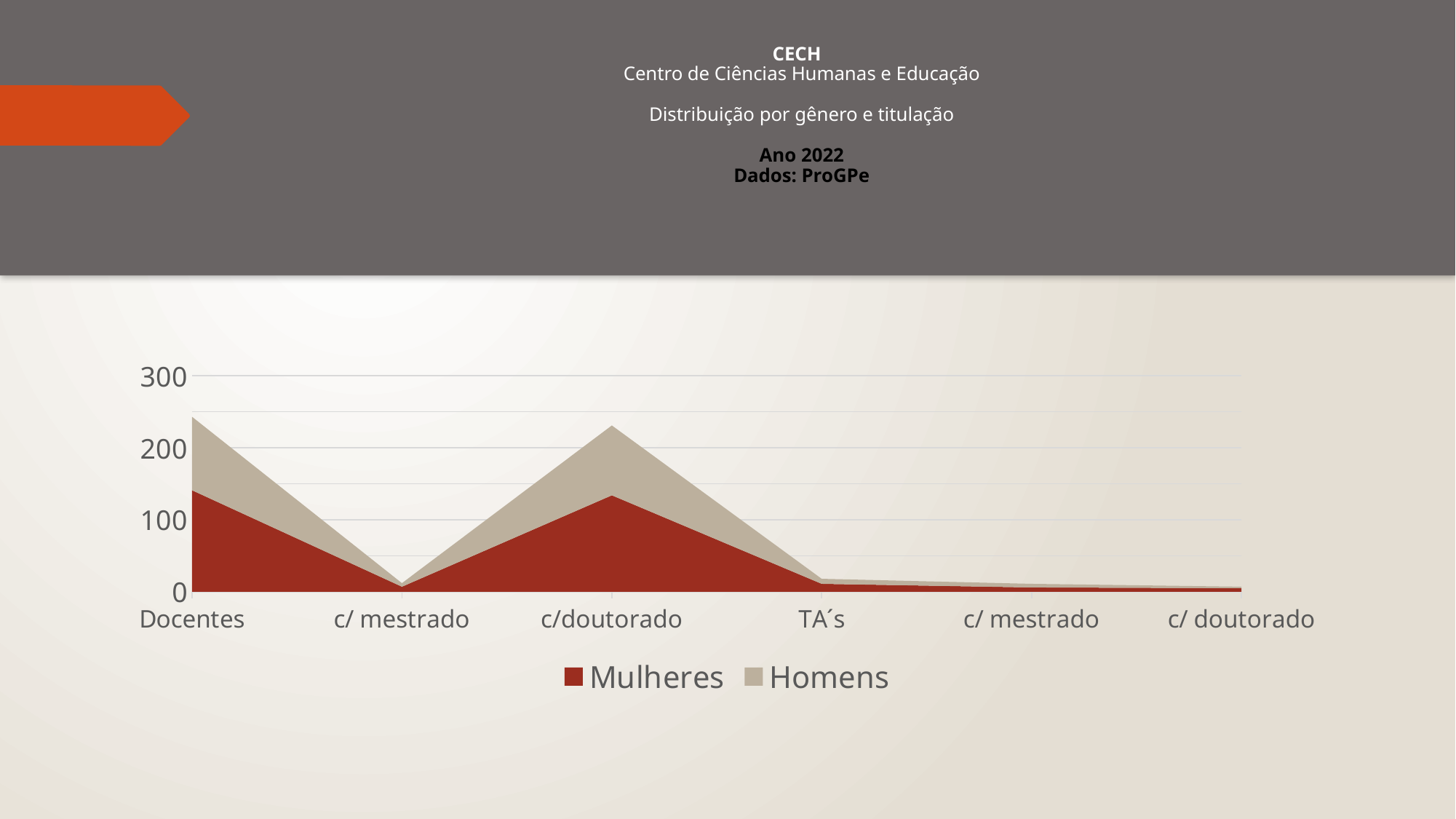
Is the combined stacked total (Mulheres plus Homens) at TA´s greater or less than 100? less Is the value for Mulheres at c/doutorado greater or less than 100? greater Which is larger for Mulheres: the value at Docentes or the value at the first c/ mestrado category? Docentes Is the value for Mulheres at Docentes greater or less than 100? greater Do the values rise or fall from Docentes to the first c/ mestrado category? fall What kind of chart is shown on the slide? area chart Which two series are listed in the legend? Mulheres and Homens What colour is used for the Mulheres series? dark red How many series does the legend list? 2 How many categories are shown along the x axis? 6